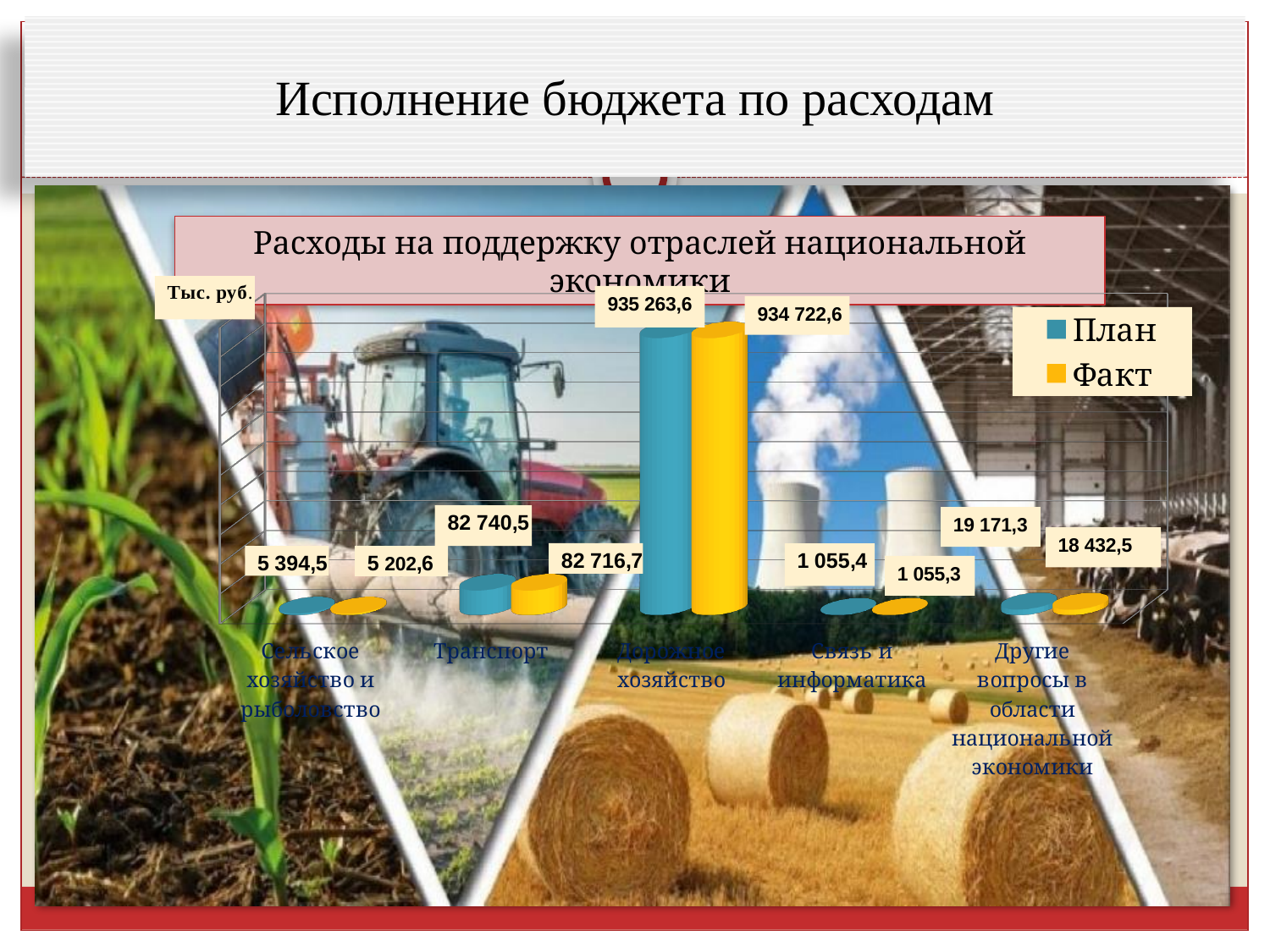
What is the difference between the План and Факт values for Другие вопросы в области национальной экономики? 738,8 How many series does the chart legend list? 2 What type of chart is shown on the slide? Bar chart What is the План value for Другие вопросы в области национальной экономики? 19 171,3 Which is larger for Транспорт, the План value or the Факт value? План What is the difference between the План and Факт values for Сельское хозяйство и рыболовство? 191,9 How many categories are shown on the x axis of the chart? 5 Which category has the lowest Факт value? Связь и информатика Which category has the highest План value? Дорожное хозяйство What is the Факт value for Сельское хозяйство и рыболовство? 5 202,6 What is the План value for Транспорт? 82 740,5 What is the Факт value for Дорожное хозяйство? 934 722,6